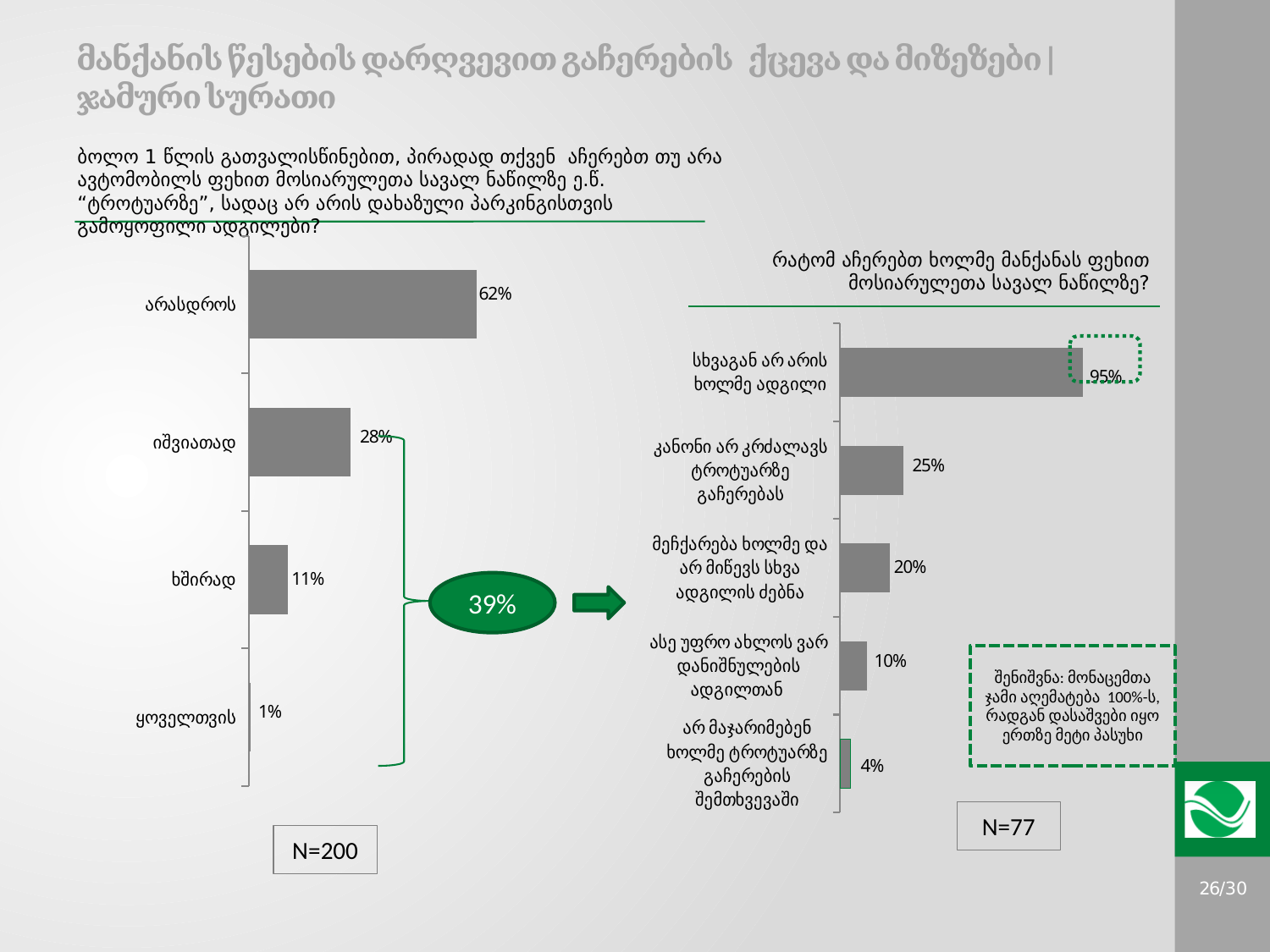
In the left chart, what is the value for არასდროს? 62% In the right chart, what is the value for მეჩქარება ხოლმე და არ მიწევს სხვა ადგილის ძებნა? 20% In the right chart, how many categories are shown? 5 In the right chart, what is the difference between the values for კანონი არ კრძალავს ტროტუარზე გაჩერებას and არ მაჯარიმებენ ხოლმე ტროტუარზე გაჩერების შემთხვევაში? 21% What type of chart is the left chart? Bar chart In the right chart, which category has the highest value? სხვაგან არ არის ხოლმე ადგილი In the left chart, which category has the lowest value? ყოველთვის In the left chart, what is the value for იშვიათად? 28% In the right chart, what is the value for სხვაგან არ არის ხოლმე ადგილი? 95% In the right chart, which is larger: the value for კანონი არ კრძალავს ტროტუარზე გაჩერებას or the value for ასე უფრო ახლოს ვარ დანიშნულების ადგილთან? კანონი არ კრძალავს ტროტუარზე გაჩერებას In the left chart, what is the difference between the values for არასდროს and იშვიათად? 34% In the left chart, how many categories are shown? 4